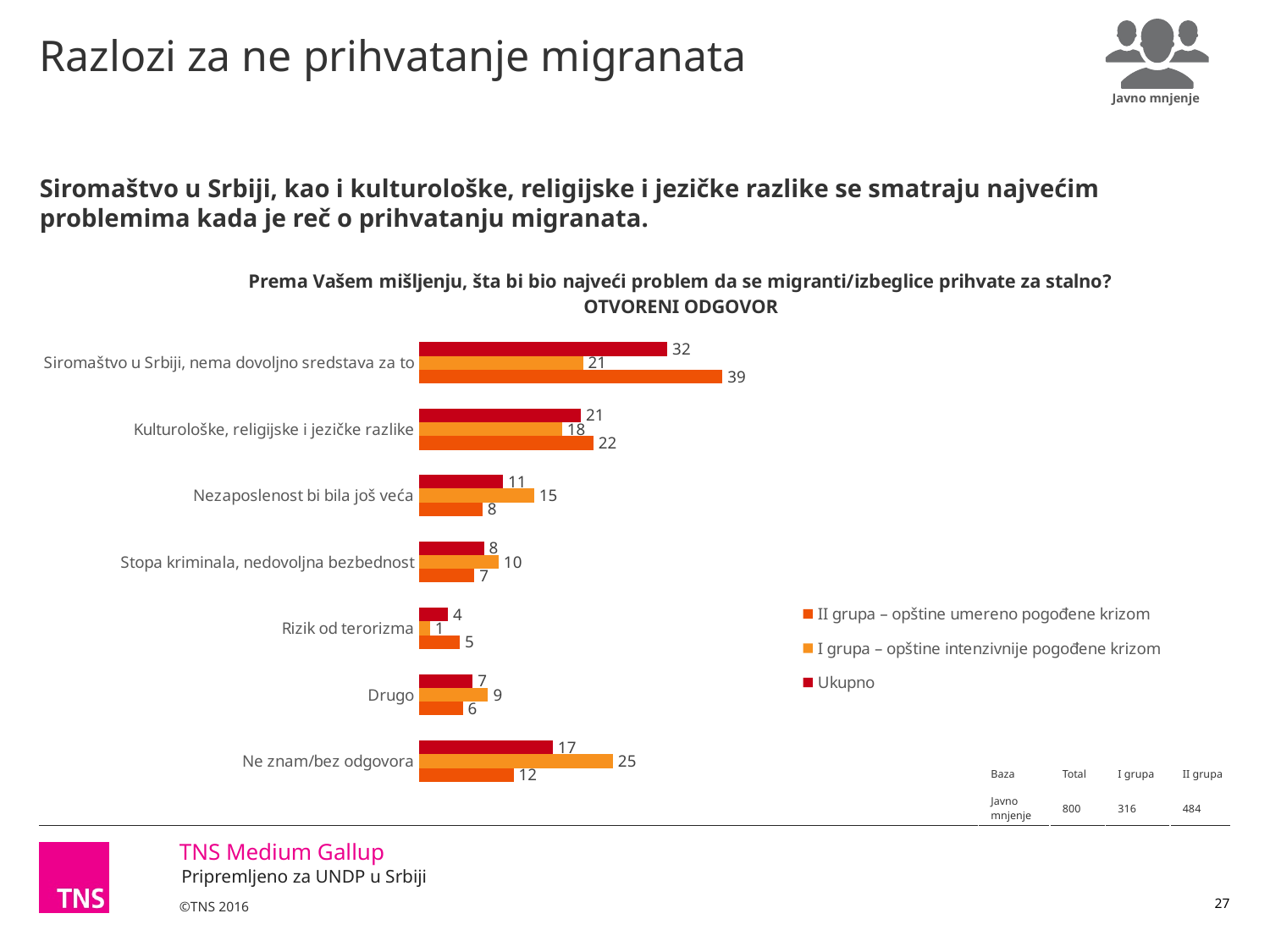
What is the Total base (Baza) shown in the table on the slide? 800 For "Nezaposlenost bi bila još veća", which is larger: the I grupa value or the II grupa value? I grupa What is the Ukupno value for "Rizik od terorizma"? 4 Which category has the lowest value for "I grupa – opštine intenzivnije pogođene krizom"? Rizik od terorizma What is the value for "I grupa – opštine intenzivnije pogođene krizom" in the category "Ne znam/bez odgovora"? 25 How many series does the legend list? 3 What type of chart is shown on the slide? Bar chart What is the value for "II grupa – opštine umereno pogođene krizom" in the category "Siromaštvo u Srbiji, nema dovoljno sredstava za to"? 39 How many categories are shown on the chart? 7 What is the difference between the II grupa and I grupa values for "Siromaštvo u Srbiji, nema dovoljno sredstava za to"? 18 What is the Ukupno value for "Siromaštvo u Srbiji, nema dovoljno sredstava za to"? 32 Which category has the highest Ukupno value? Siromaštvo u Srbiji, nema dovoljno sredstava za to